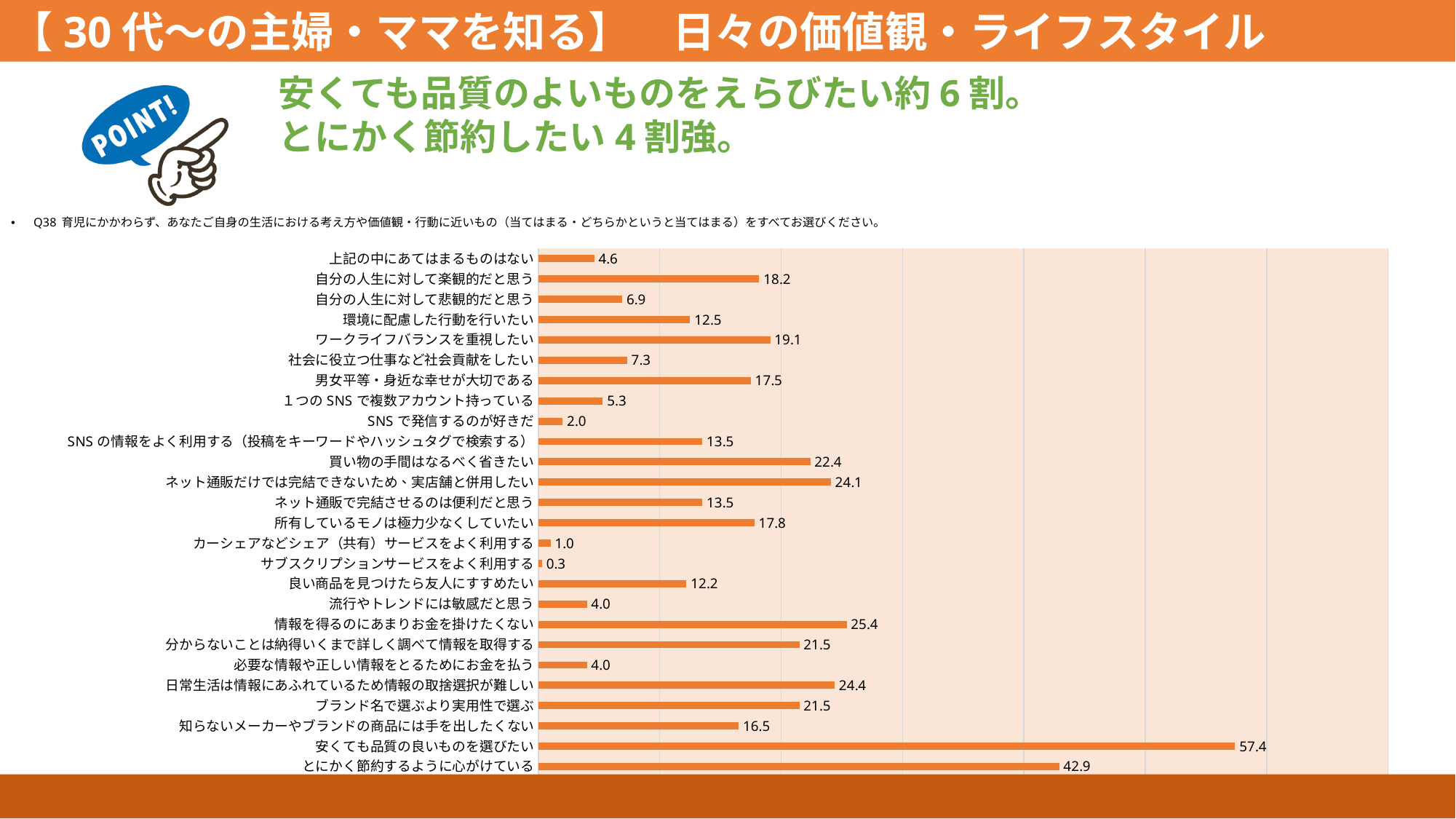
What is the value for ワークライフバランスを重視したい? 19.1 What is the value for 安くても品質の良いものを選びたい? 57.4 What colour are the bars in the chart? orange Which category has the lowest value? サブスクリプションサービスをよく利用する What is the value for サブスクリプションサービスをよく利用する? 0.3 Which is larger: the value for 買い物の手間はなるべく省きたい or the value for ネット通販だけでは完結できないため、実店舗と併用したい? ネット通販だけでは完結できないため、実店舗と併用したい What is the value for とにかく節約するように心がけている? 42.9 What type of chart is shown on the slide? bar chart Which category has the highest value? 安くても品質の良いものを選びたい What is the difference between the values for 安くても品質の良いものを選びたい and とにかく節約するように心がけている? 14.5 How many categories are plotted in the chart? 26 What is the difference between the values for 自分の人生に対して楽観的だと思う and 自分の人生に対して悲観的だと思う? 11.3